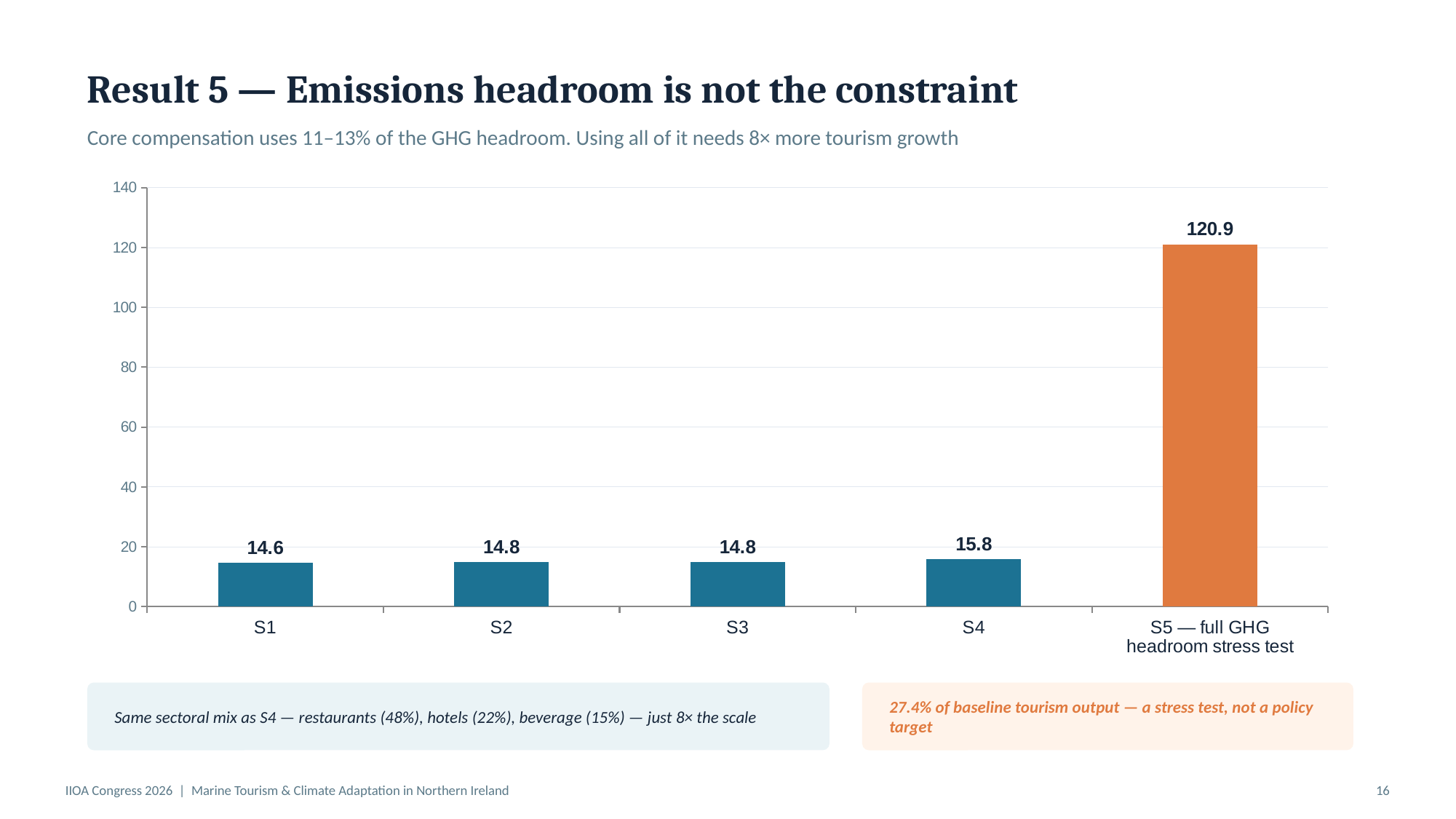
Is the value for S5 — full GHG headroom stress test greater or less than 100? greater Which category has the lowest value? S1 What is the value for S1? 14.6 Which category has the highest value? S5 — full GHG headroom stress test Which is larger, the value for S4 or the value for S2? S4 What kind of chart is shown on the slide? bar chart What is the difference between the values for S5 — full GHG headroom stress test and S4? 105.1 What is the difference between the values for S4 and S1? 1.2 What is the value for S5 — full GHG headroom stress test? 120.9 How many categories are shown on the x axis? 5 What is the value for S4? 15.8 Which bar is coloured orange rather than blue? S5 — full GHG headroom stress test